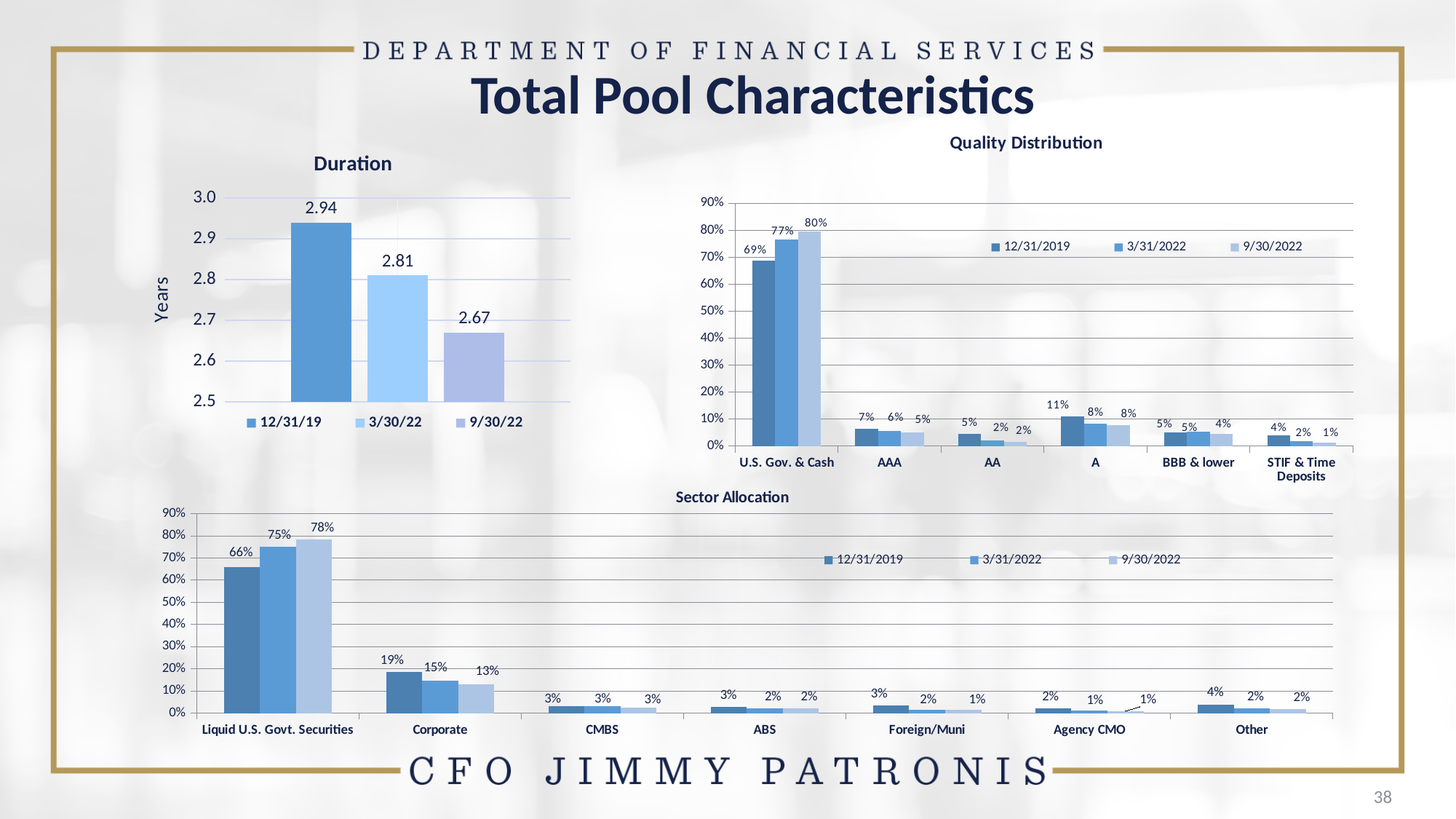
In the Duration chart, what is the difference between the 12/31/19 and 3/30/22 values? 0.13 In the Quality Distribution chart, how many categories are shown on the x axis? 6 In the Quality Distribution chart, what is the value for U.S. Gov. & Cash on 9/30/2022? 80% In the Duration chart, which date has the highest duration? 12/31/19 In the Duration chart, do the values rise or fall from 12/31/19 to 9/30/22? fall In the Duration chart, what is the value for 9/30/22? 2.67 In the Quality Distribution chart, how many series does the legend list? 3 In the Quality Distribution chart, what is the value for A on 12/31/2019? 11% In the Sector Allocation chart, what is the value for Corporate on 3/31/2022? 15% In the Sector Allocation chart, what is the difference between the 12/31/2019 and 9/30/2022 values for Liquid U.S. Govt. Securities? 12% In the Sector Allocation chart, which category has the highest value for 9/30/2022? Liquid U.S. Govt. Securities What kind of chart is the Sector Allocation chart? bar chart